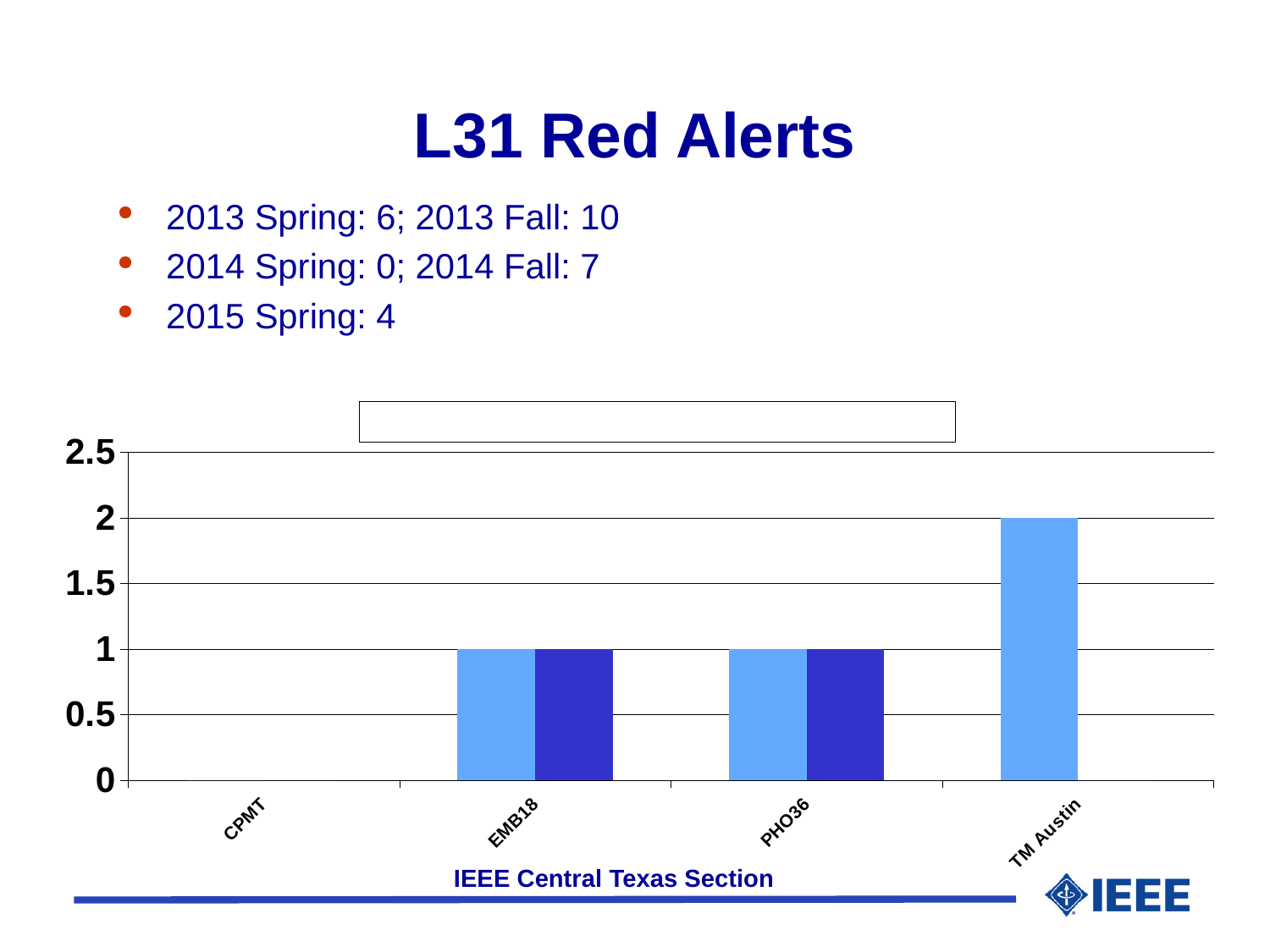
Which is larger: the light blue bar for TM Austin or the light blue bar for EMB18? TM Austin What is the difference between the light blue bar for TM Austin and the light blue bar for PHO36? 1 What is the value of the dark blue bar for PHO36? 1 What is the value of the light blue bar for EMB18? 1 Which category has the tallest bar in the chart? TM Austin What is the first category listed on the x axis of the chart? CPMT How many categories are shown on the x axis of the chart? 4 What kind of chart is shown on the slide? bar chart Which category on the x axis has no visible bars? CPMT Is the value of the light blue bar for TM Austin greater or less than 1.5? greater What is the highest value labelled on the y axis of the chart? 2.5 What is the value of the light blue bar for TM Austin? 2